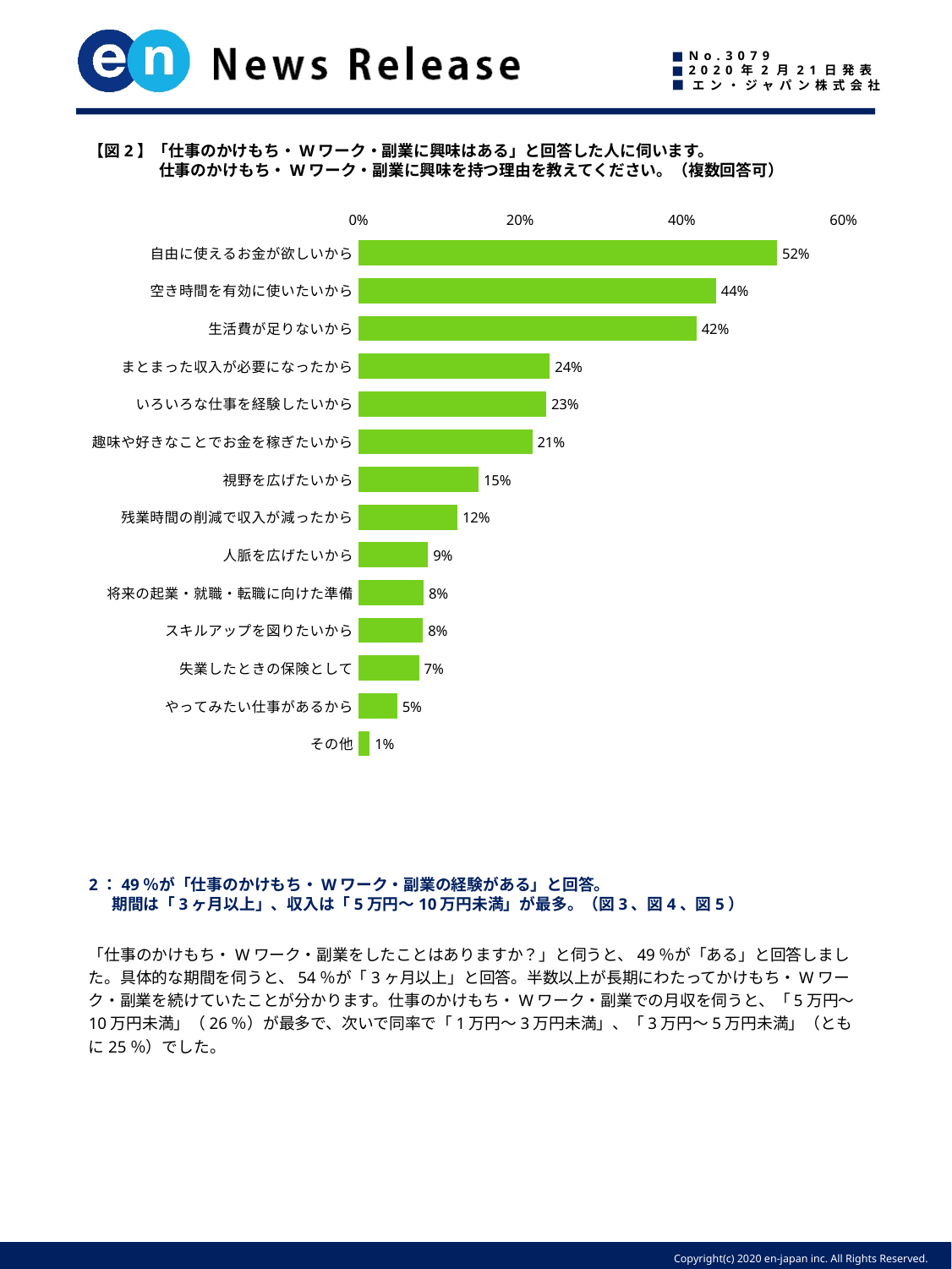
What is the value for 自由に使えるお金が欲しいから? 52% What kind of chart is shown? bar chart Which is larger, 残業時間の削減で収入が減ったから or 人脈を広げたいから? 残業時間の削減で収入が減ったから Which category has the highest value? 自由に使えるお金が欲しいから Which category has the lowest value? その他 How many categories are shown in the chart? 14 Is the value for 趣味や好きなことでお金を稼ぎたいから greater or less than 20%? greater What is the difference between 空き時間を有効に使いたいから and まとまった収入が必要になったから? 20% What is the difference between 失業したときの保険として and やってみたい仕事があるから? 2% What is the maximum value shown on the horizontal axis? 60% What is the value for 生活費が足りないから? 42% What is the value for 視野を広げたいから? 15%